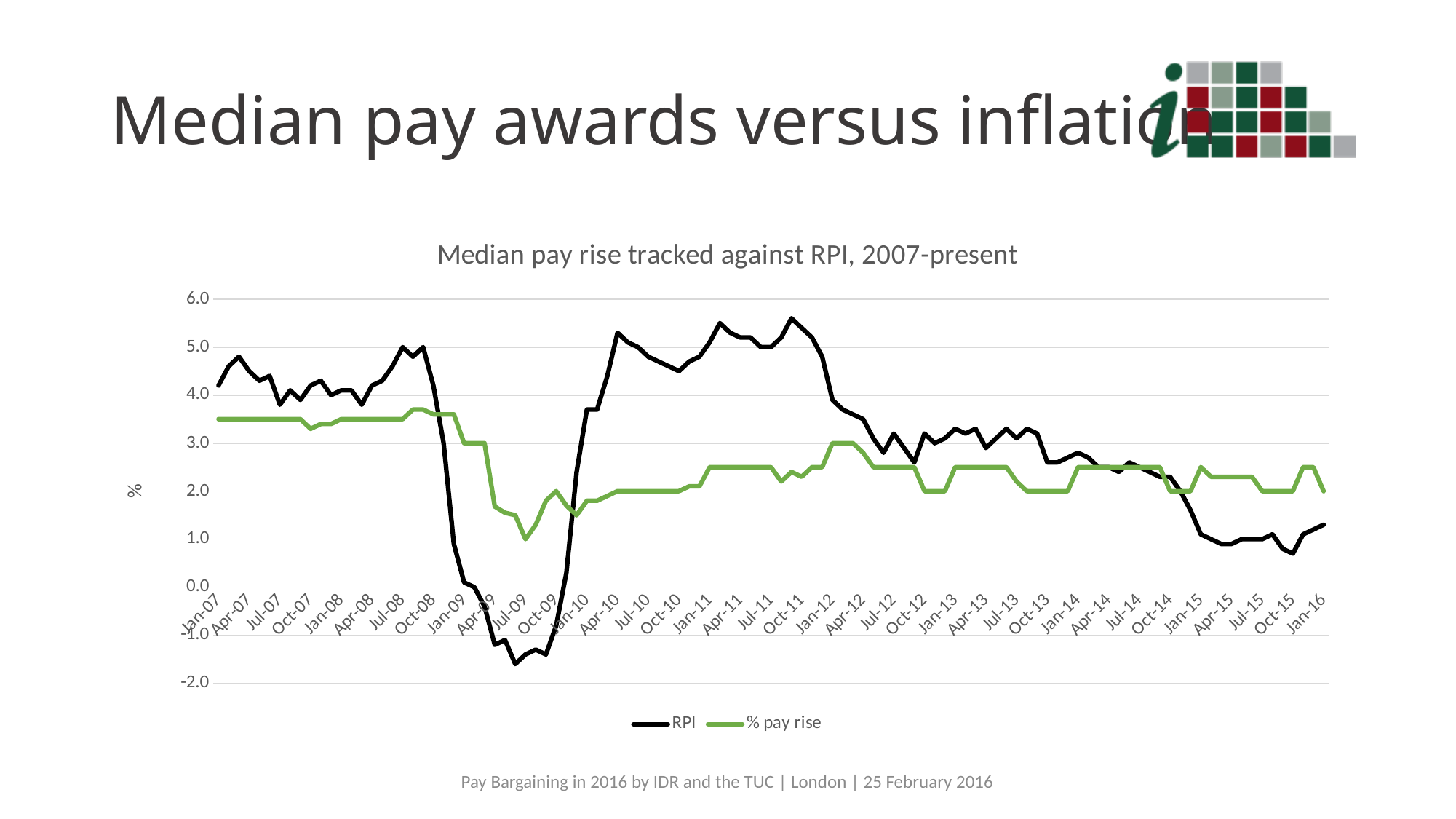
How many series does the legend list? 2 What kind of chart is shown on the slide? Line chart What is the title of the chart? Median pay rise tracked against RPI, 2007-present Is the % pay rise value at Jan-07 greater or less than 3.0? greater Is the RPI value at Apr-11 greater or less than 5.0? greater Which series is drawn in green? % pay rise Is the RPI value at Apr-15 greater or less than 2.0? less At Apr-11, which series has the higher value, RPI or % pay rise? RPI Around which x-axis label does the RPI series reach its lowest point? Jul-09 Does the RPI series rise or fall between Jan-12 and Jan-15? Fall At Jul-09, which series has the higher value, RPI or % pay rise? % pay rise